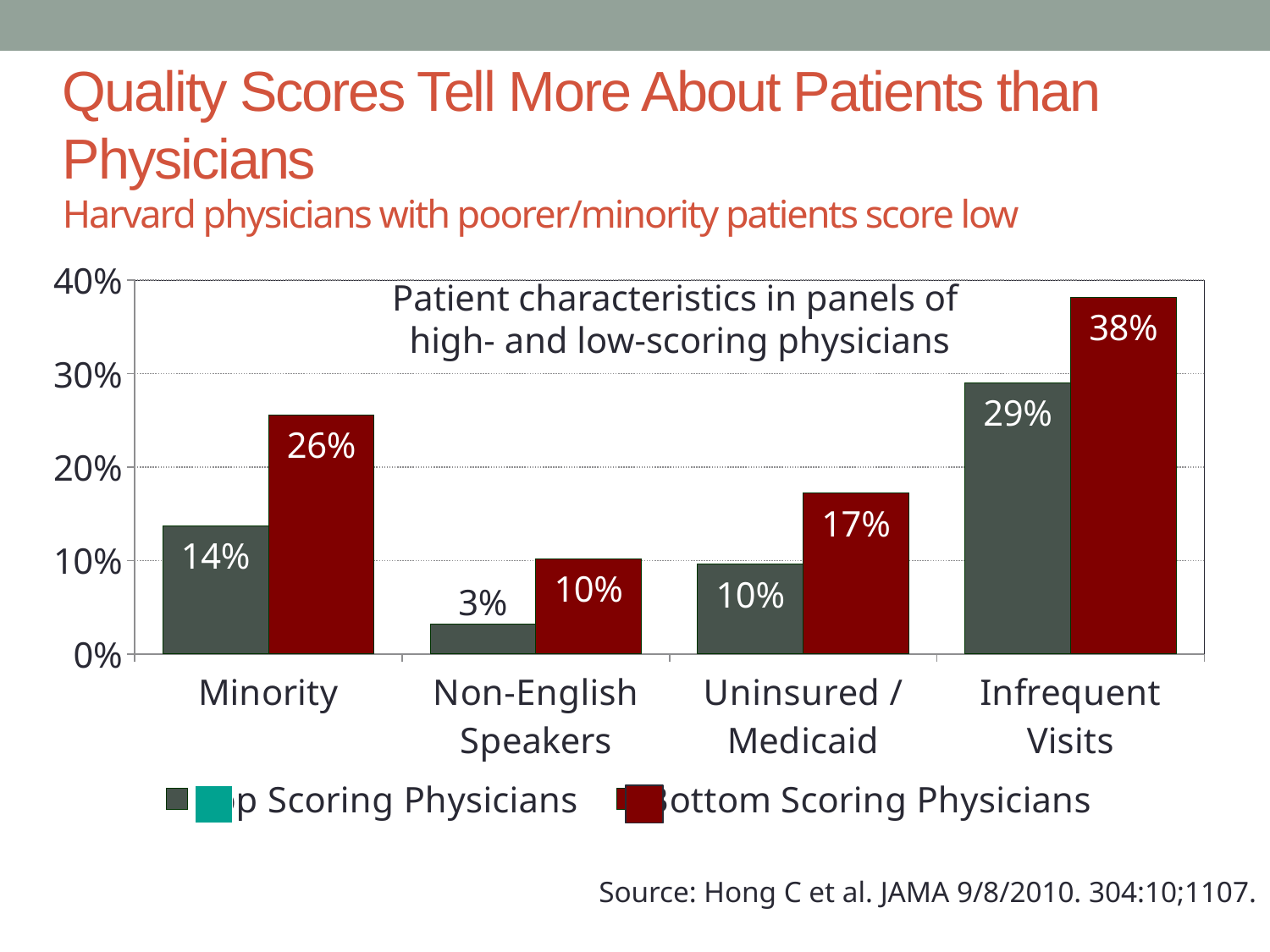
Which category has the lowest value for Top Scoring Physicians? Non-English Speakers Which category has the highest value for Bottom Scoring Physicians? Infrequent Visits What is the value for Minority among Bottom Scoring Physicians? 26% What is the difference between the Bottom Scoring and Top Scoring Physicians values for Minority? 12% What is the difference between the Bottom Scoring and Top Scoring Physicians values for Infrequent Visits? 9% How many categories are shown on the x axis? 4 What kind of chart is shown on the slide? Bar chart What is the value for Uninsured / Medicaid among Top Scoring Physicians? 10% What is the value for Non-English Speakers among Top Scoring Physicians? 3% How many series does the legend list? 2 What is the value for Infrequent Visits among Bottom Scoring Physicians? 38% Which is larger: the Uninsured / Medicaid value for Bottom Scoring Physicians or the Minority value for Top Scoring Physicians? Uninsured / Medicaid for Bottom Scoring Physicians